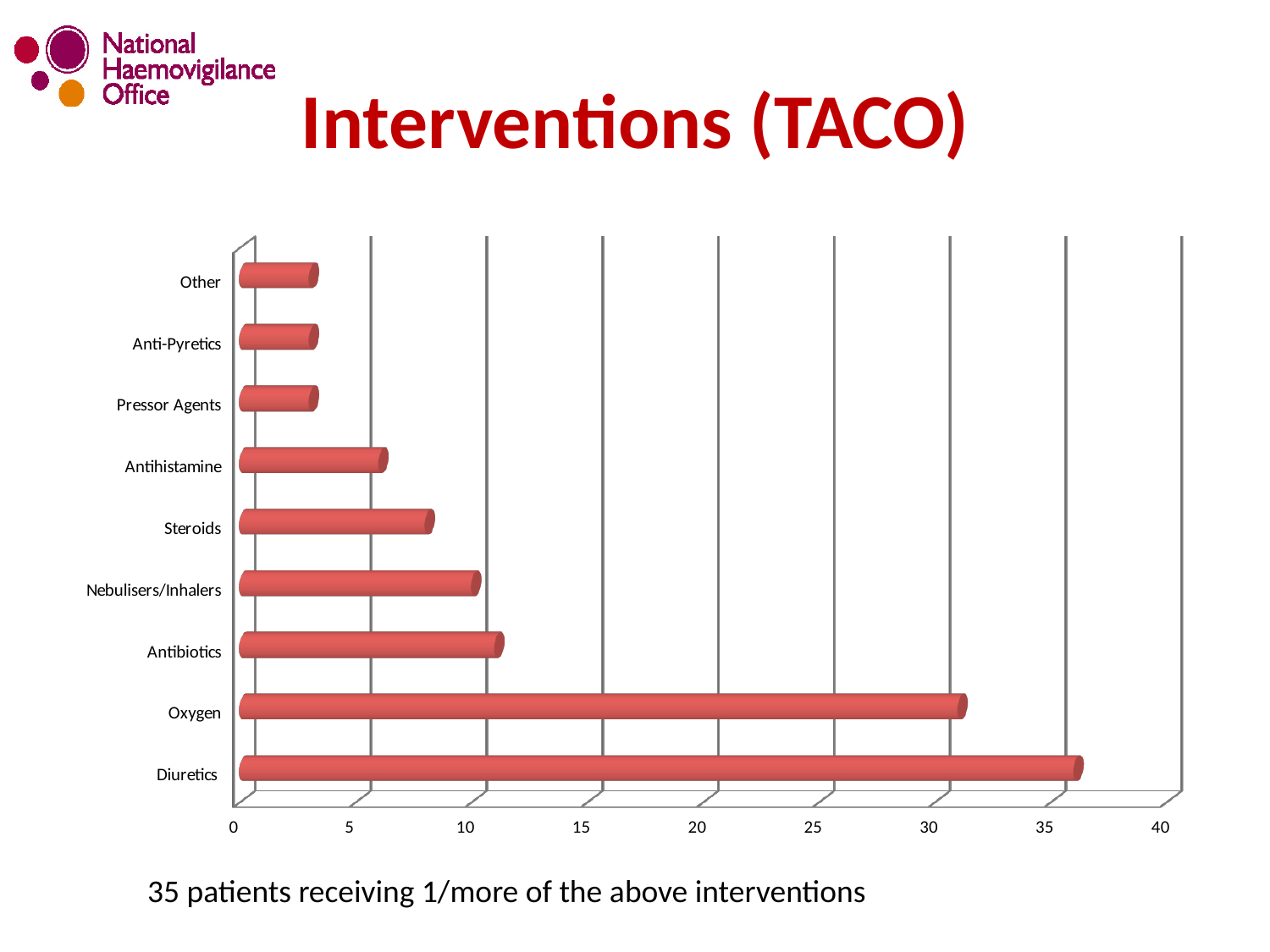
What kind of chart is shown on the slide? bar chart Is the value for Oxygen greater or less than 25? greater Which is larger, the value for Diuretics or the value for Oxygen? Diuretics Is the value for Diuretics greater or less than 30? greater How many intervention categories are plotted on the chart? 9 Is the value for Steroids greater or less than 10? less What is the title of the slide containing the chart? Interventions (TACO) Which intervention has the highest value on the chart? Diuretics Which is larger, the value for Steroids or the value for Antihistamine? Steroids What is the highest value shown on the horizontal axis of the chart? 40